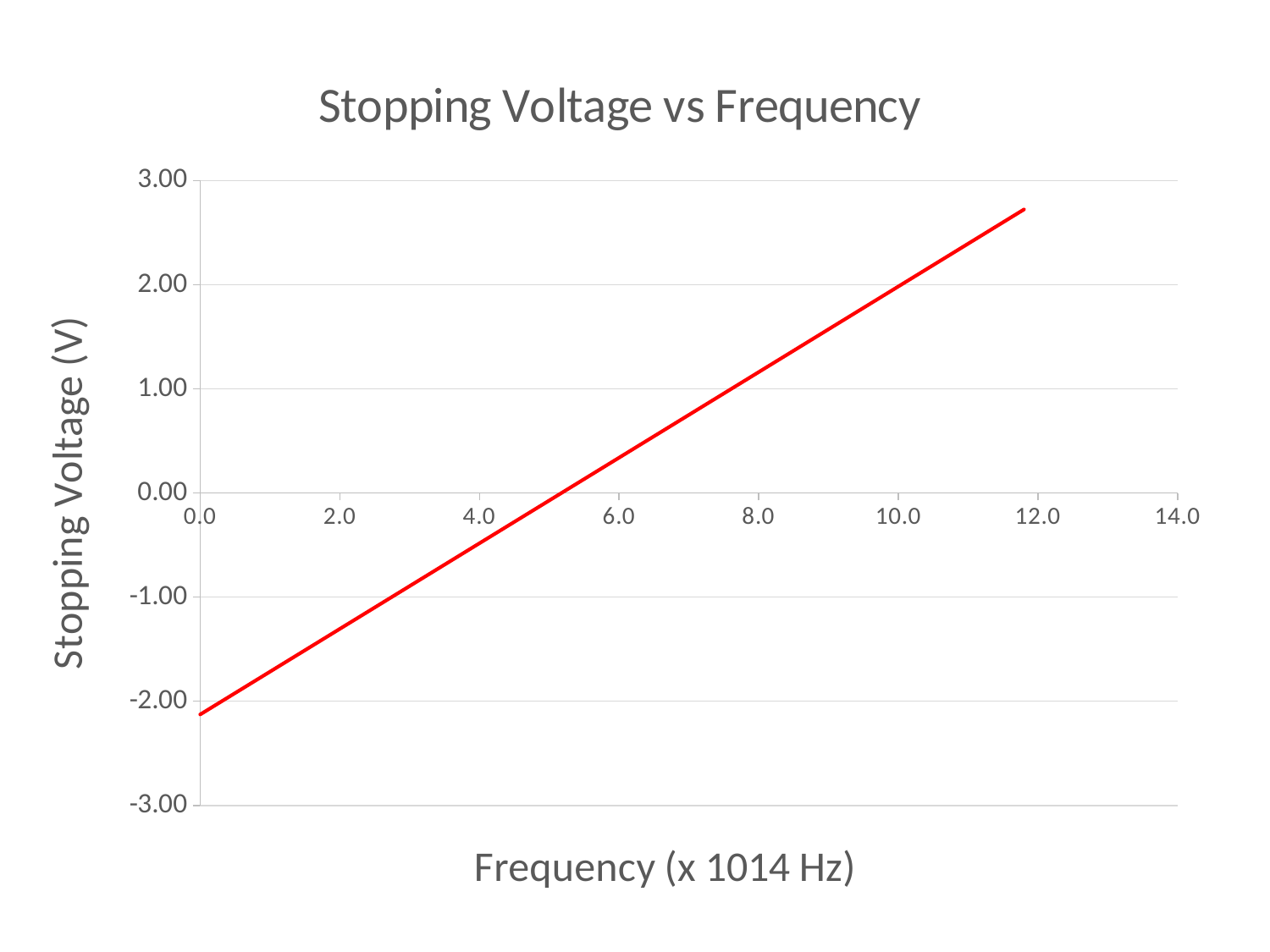
How many lines are plotted on the chart? 1 What is the label of the y axis? Stopping Voltage (V) Is the stopping voltage at a frequency of 10.0 greater or less than 1.00 V? greater Does the stopping voltage rise or fall as frequency increases along the x axis? rise What kind of chart is shown on the slide? line chart Is the stopping voltage at a frequency of 2.0 greater or less than 0.00 V? less Is the stopping voltage at a frequency of 0.0 greater or less than -3.00 V? greater What is the title of the chart? Stopping Voltage vs Frequency